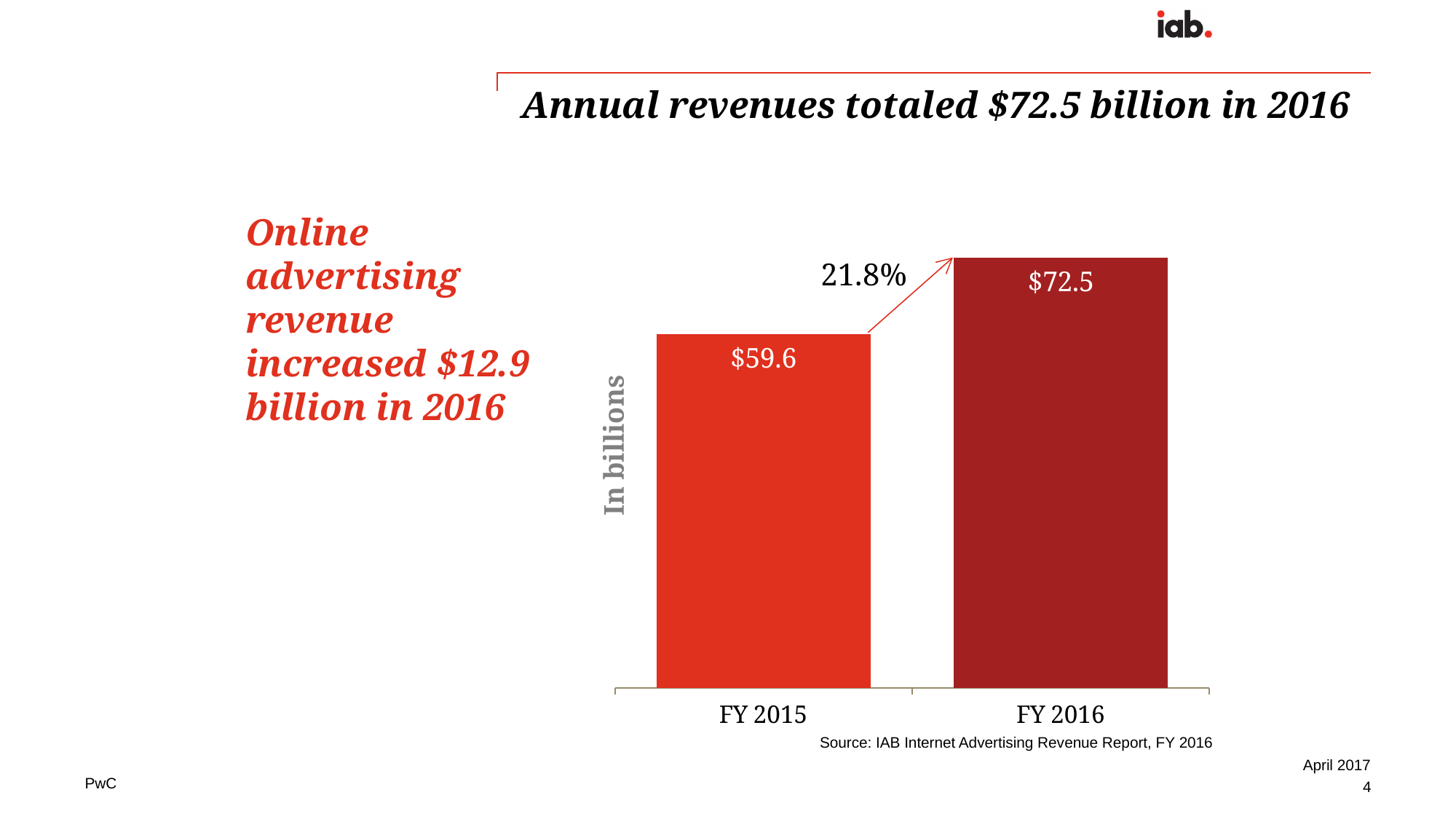
Do the values rise or fall from FY 2015 to FY 2016? Rise How many categories are shown on the x axis? 2 What kind of chart is shown? Bar chart Is the value for FY 2016 larger than the value for FY 2015? Yes What percentage change is labeled between the two bars? 21.8% What is the label on the vertical axis? In billions Which year has the higher value? FY 2016 What is the value for FY 2016? $72.5 What is the value for FY 2015? $59.6 Which year has the lower value? FY 2015 What is the difference between the FY 2016 and FY 2015 values? $12.9